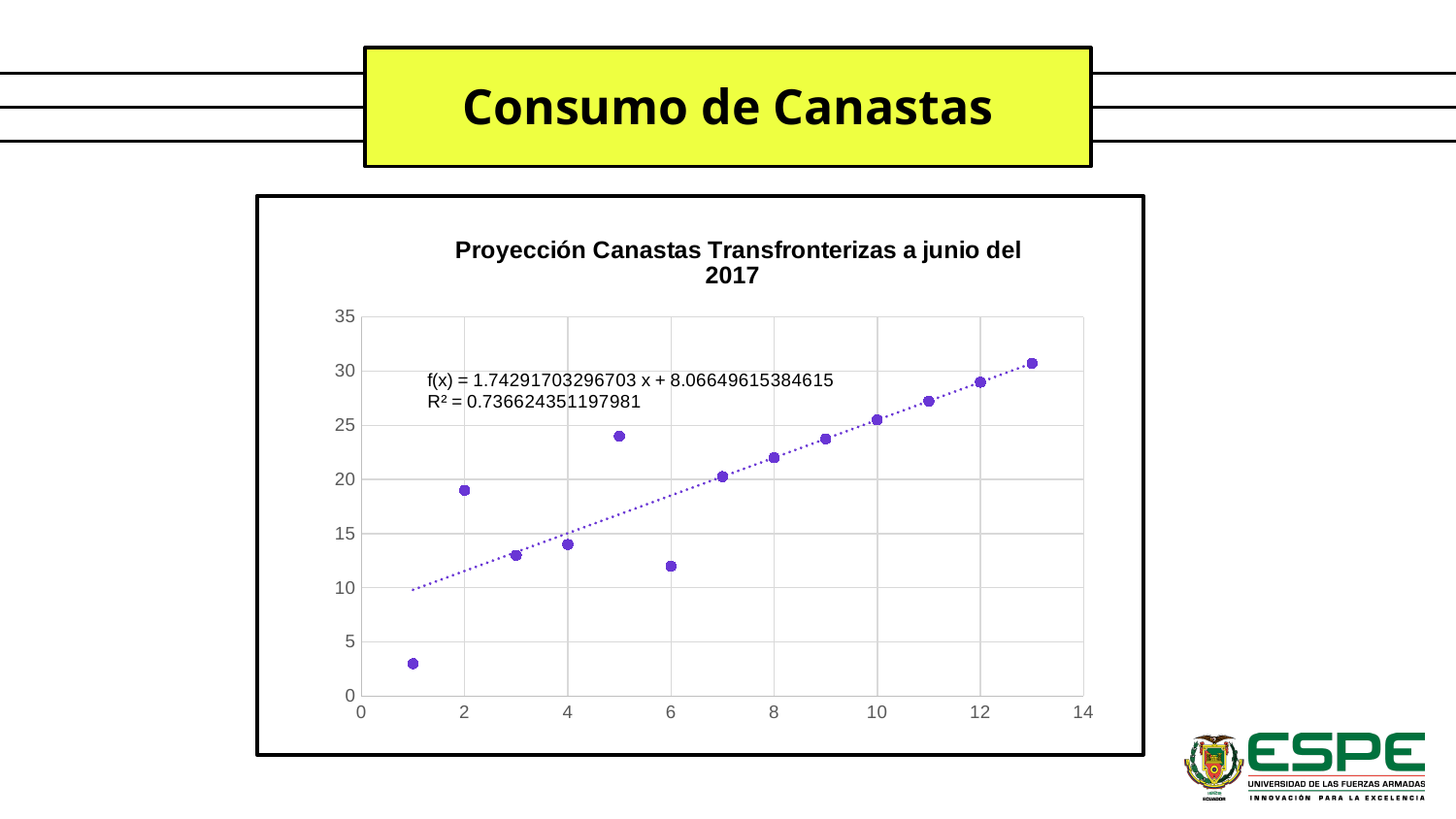
Is the value at x = 13 greater or less than 30? greater Which x value has the highest plotted point? 13 Which has the larger value, the point at x = 5 or the point at x = 6? x = 5 How many data points are plotted in the chart? 13 Is the value at x = 1 greater or less than 5? less Which has the larger value, the point at x = 2 or the point at x = 3? x = 2 Is the value at x = 6 greater or less than 15? less Do the plotted values generally rise or fall as x increases? Rise What kind of chart is shown on the slide? Scatter chart What R² value is printed on the chart for the trendline? 0.736624351197981 What is the title of the chart? Proyección Canastas Transfronterizas a junio del 2017 Which x value has the lowest plotted point? 1